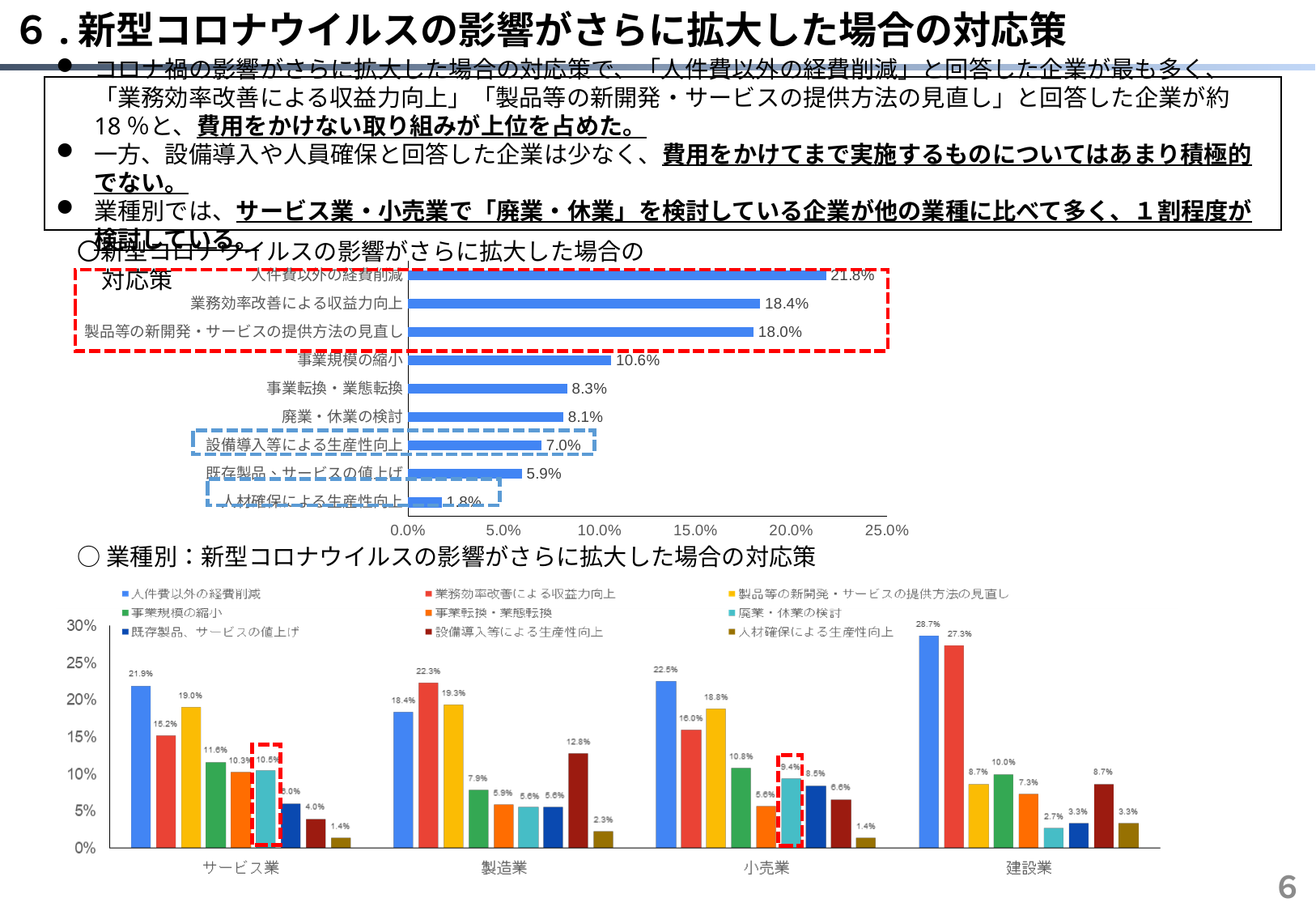
In the top chart, which is larger: 事業規模の縮小 or 設備導入等による生産性向上? 事業規模の縮小 In the bottom chart (業種別), what is the value of 設備導入等による生産性向上 for 製造業? 12.8% In the top chart, what is the difference between 人件費以外の経費削減 and 業務効率改善による収益力向上? 3.4 percentage points How many industry categories are shown on the x axis of the bottom chart (業種別)? 4 In the bottom chart (業種別), what is the value of 人件費以外の経費削減 for 建設業? 28.7% In the bottom chart (業種別), which industry has the highest value for 人件費以外の経費削減? 建設業 How many categories are shown in the top chart? 9 In the top chart, which category has the lowest value? 人材確保による生産性向上 How many series does the legend of the bottom chart (業種別) list? 9 In the top chart, which category has the highest value? 人件費以外の経費削減 In the top chart, what is the value for 事業規模の縮小? 10.6% What kind of chart is the top chart (新型コロナウイルスの影響がさらに拡大した場合の対応策)? bar chart